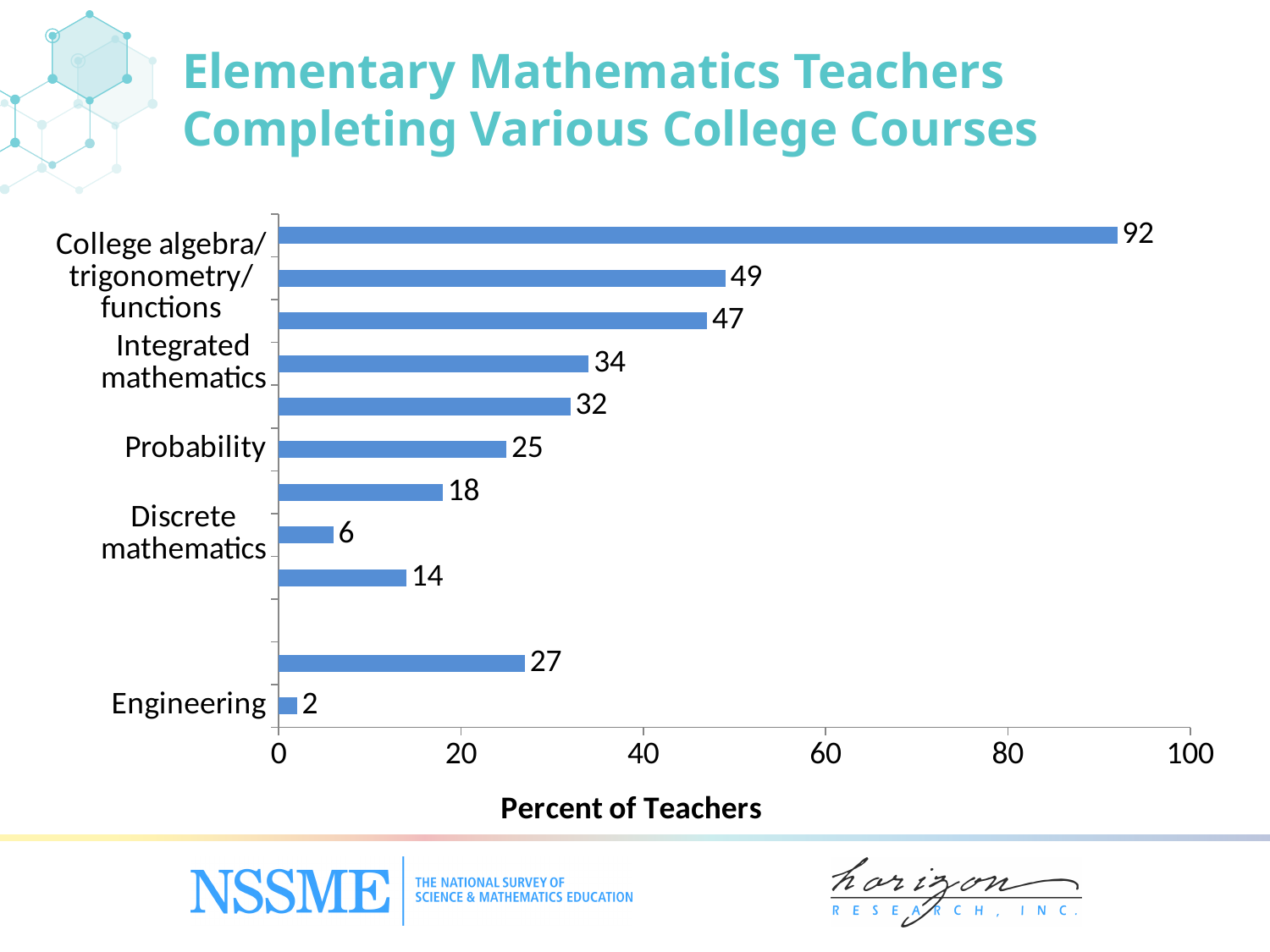
What is the difference between the values for Probability and Discrete mathematics? 19 Which labeled course has the lowest percent of teachers? Engineering Which is larger, the value for Probability or the value for Discrete mathematics? Probability What percent of teachers completed a course in Discrete mathematics? 6 Is the value for Integrated mathematics greater or less than 20? greater How many bars are plotted in the chart? 11 What percent of teachers completed a course in Engineering? 2 What is the highest value shown on any bar in the chart? 92 What percent of teachers completed a course in Integrated mathematics? 34 What percent of teachers completed a course in Probability? 25 What is the title of the horizontal axis? Percent of Teachers What kind of chart is shown on the slide? bar chart